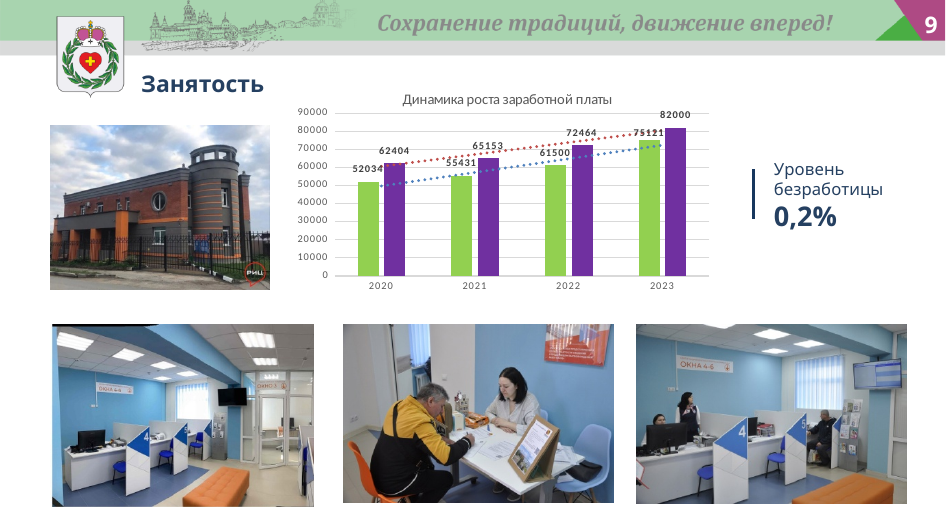
Do the green bar values rise or fall from 2020 to 2023? rise What is the value of the purple bar for 2023? 82000 What is the difference between the purple bar and the green bar in 2023? 6879 How many years are shown on the x axis of the chart? 4 What type of chart is shown on the slide? bar chart In which year is the green bar the highest? 2023 What is the title of the chart on the slide? Динамика роста заработной платы In which year is the purple bar the lowest? 2020 What is the value of the purple bar for 2021? 65153 Which is larger in 2021: the green bar or the purple bar? the purple bar What is the value of the green bar for 2022? 61500 What is the value of the green bar for 2020? 52034